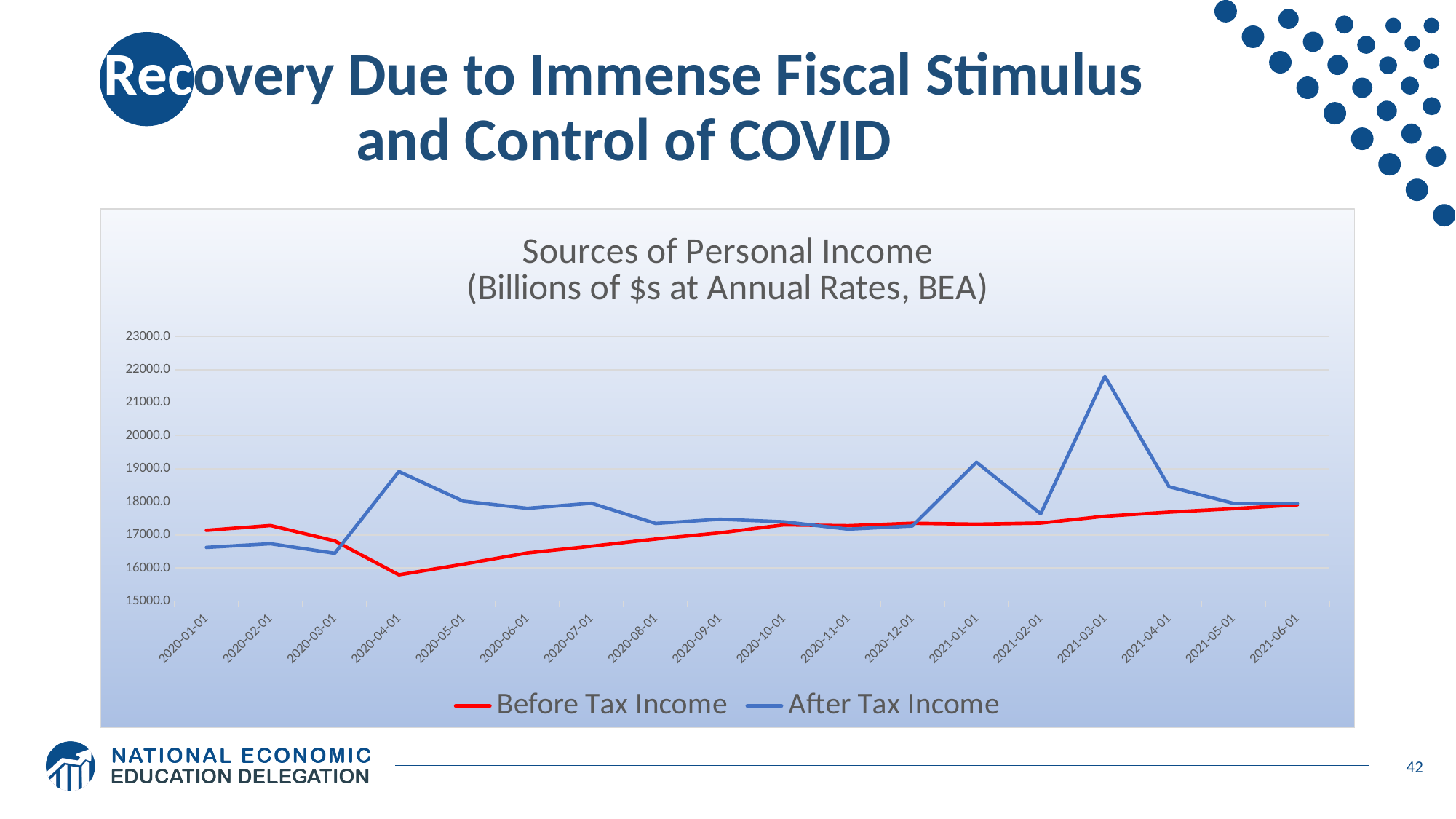
What colour is the line for After Tax Income? blue How many dates are plotted along the x axis? 18 At which date does Before Tax Income reach its lowest value? 2020-04-01 Is the value for Before Tax Income at 2020-06-01 greater or less than 17000.0? less Is the value for After Tax Income at 2020-04-01 greater or less than 18000.0? greater At which date does After Tax Income reach its highest value? 2021-03-01 Is the value for Before Tax Income at 2020-04-01 greater or less than 16000.0? less What kind of chart is shown on the slide? line chart How many series does the legend list? 2 At 2020-04-01, which series has the larger value, Before Tax Income or After Tax Income? After Tax Income Does Before Tax Income rise or fall from 2020-04-01 to 2021-06-01? rise